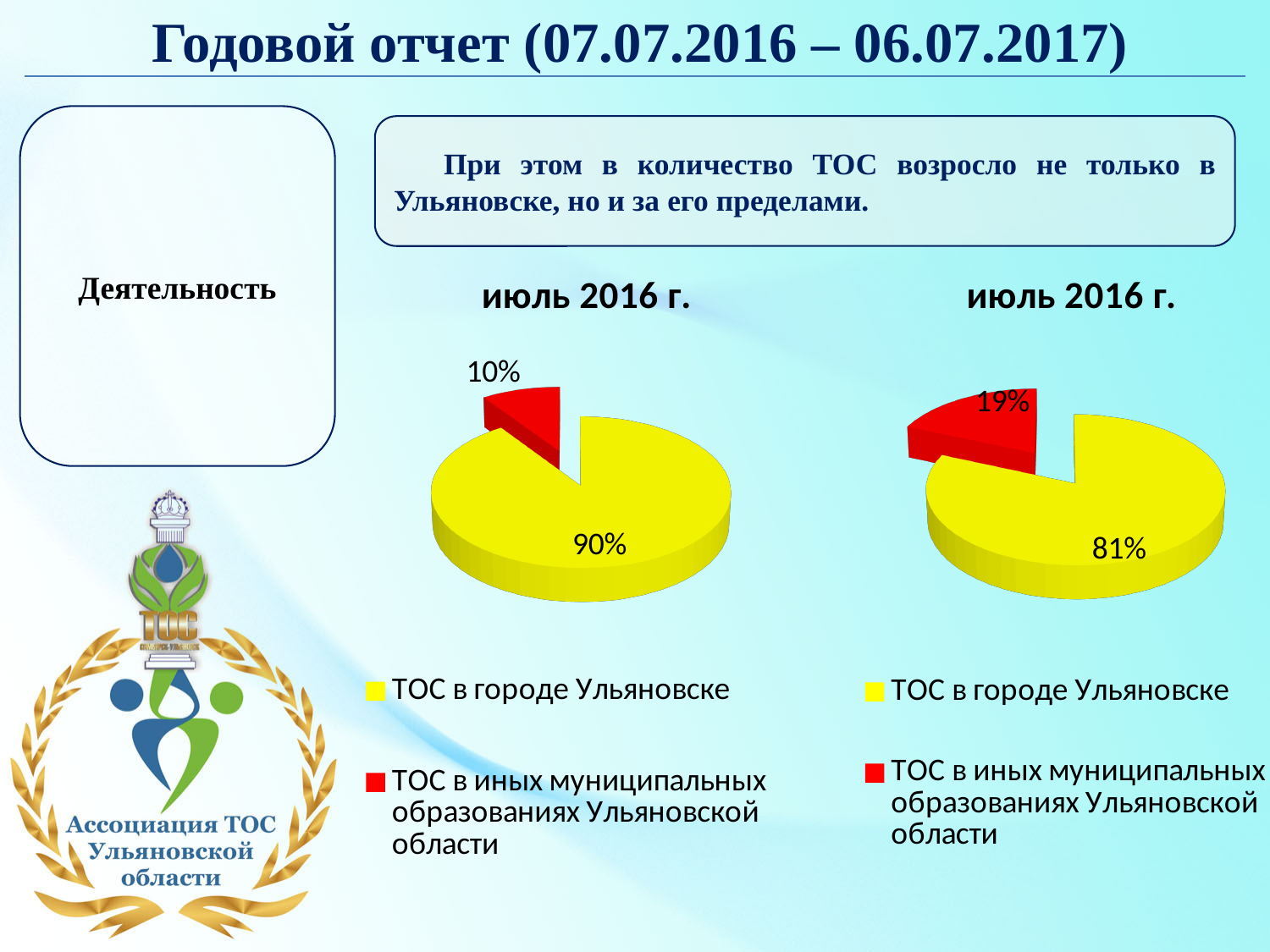
In the right pie chart, which category has the smallest slice? ТОС в иных муниципальных образованиях Ульяновской области How many slices does the right pie chart have? 2 Which is larger: the share for ТОС в иных муниципальных образованиях Ульяновской области in the left pie chart or in the right pie chart? the right pie chart In the right pie chart, what colour is the slice for ТОС в городе Ульяновске? yellow What kind of chart is the left chart on the slide? pie chart In the left pie chart, which category has the largest slice? ТОС в городе Ульяновске In the right pie chart, what share is labelled for ТОС в иных муниципальных образованиях Ульяновской области? 19% In the right pie chart, what share is labelled for ТОС в городе Ульяновске? 81% In the left pie chart, what is the difference between the share for ТОС в городе Ульяновске and the share for ТОС в иных муниципальных образованиях Ульяновской области? 80% In the left pie chart, what share is labelled for ТОС в городе Ульяновске? 90% In the left pie chart, what share is labelled for ТОС в иных муниципальных образованиях Ульяновской области? 10% How many entries does the legend of the left pie chart list? 2